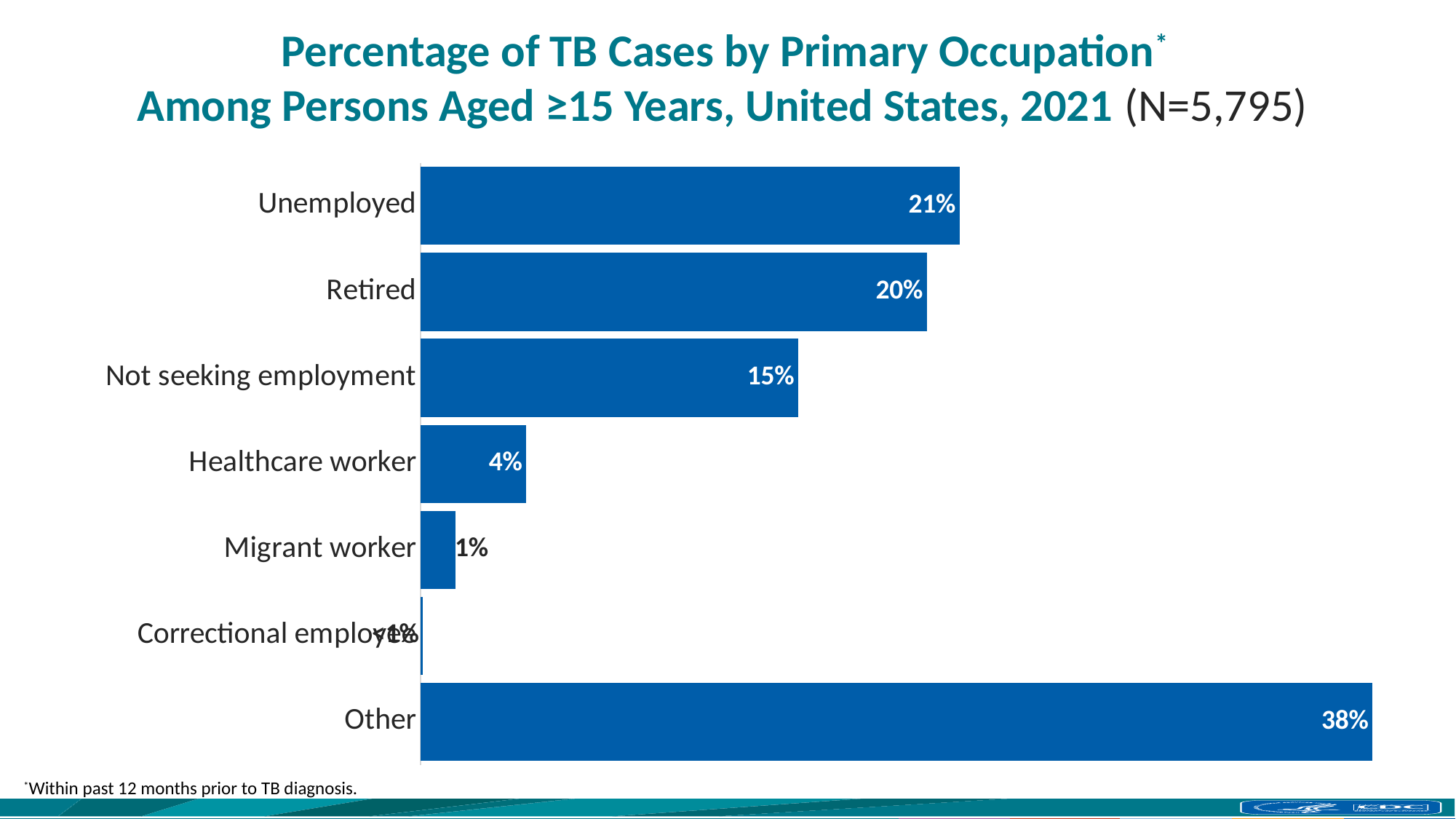
Which occupation category has the highest percentage of TB cases? Other What is the total number of cases (N) stated in the chart title? 5,795 What type of chart is shown on the slide? Bar chart What percentage of TB cases is shown for Retired? 20% What is the difference in percentage points between Other and Unemployed? 17 What percentage of TB cases is shown for Unemployed? 21% What percentage of TB cases is shown for Not seeking employment? 15% What is the difference in percentage points between Not seeking employment and Healthcare worker? 11 What percentage of TB cases is shown for Migrant worker? 1% What percentage of TB cases is shown for Healthcare worker? 4% Which has a larger percentage of TB cases, Retired or Healthcare worker? Retired How many occupation categories are shown in the chart? 7